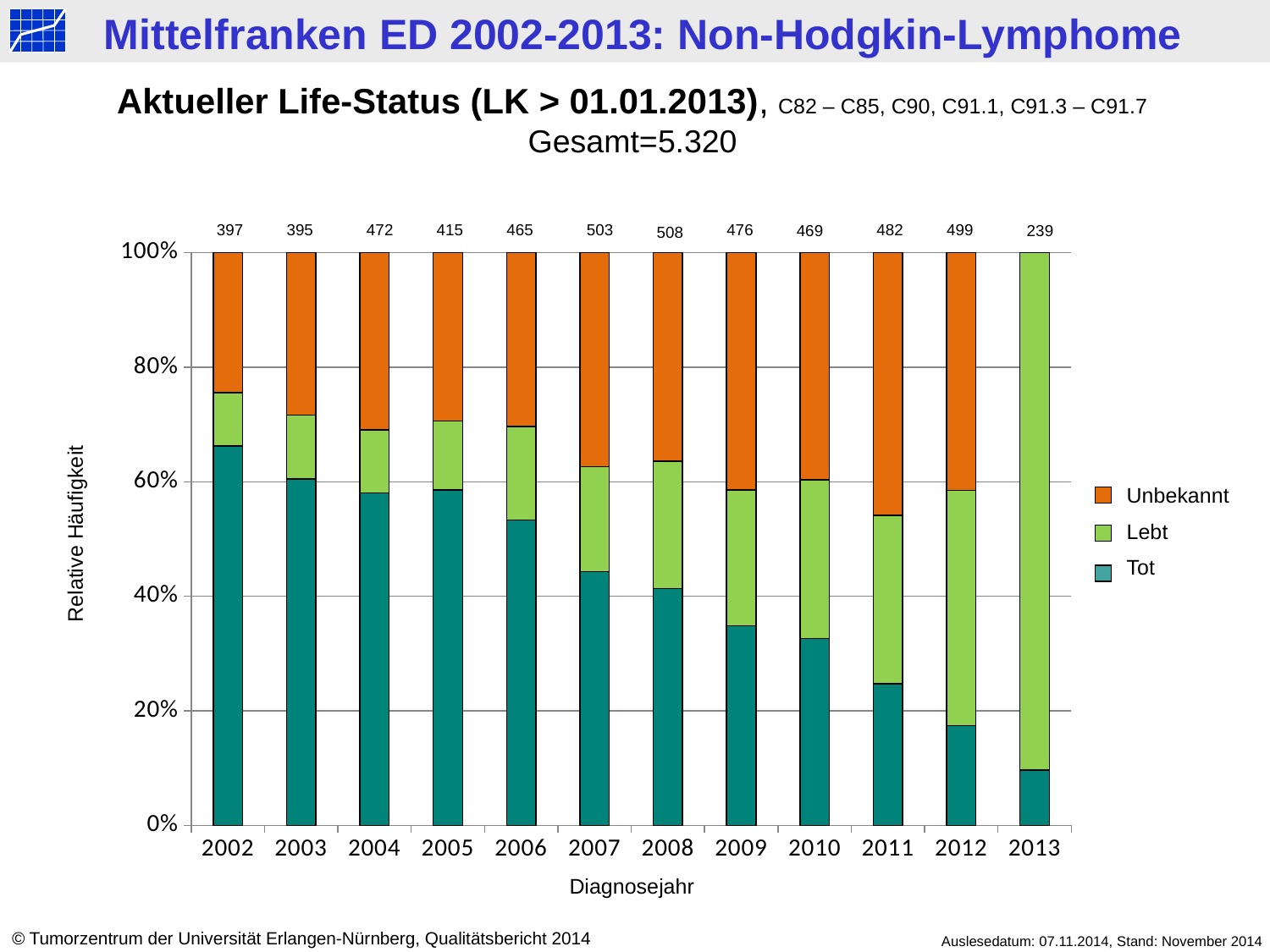
What number is printed above the bar for 2002? 397 Which year has the highest number printed above its bar? 2008 How many series does the legend list? 3 Which year has the larger number printed above its bar, 2004 or 2005? 2004 What number is printed above the bar for 2007? 503 Which year has the lowest number printed above its bar? 2013 Does the Tot share rise or fall from 2002 to 2013? fall What is the difference between the numbers printed above the bars for 2008 and 2013? 269 Is the Tot share for 2002 greater or less than 60%? greater How many diagnosis years are shown on the x axis? 12 What number is printed above the bar for 2013? 239 Is the Tot share for 2013 greater or less than 20%? less